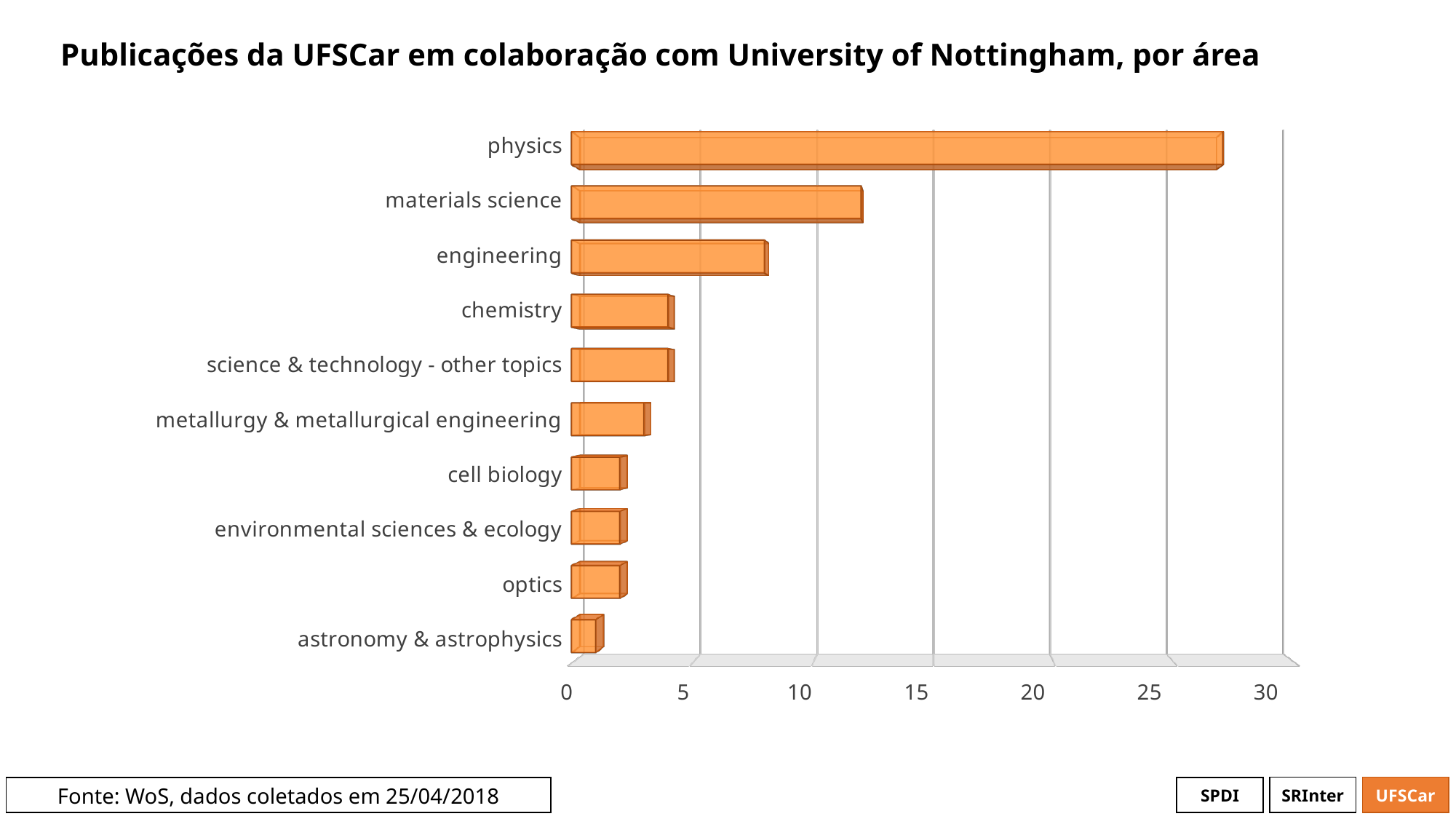
Is the value for materials science greater or less than 10? greater How many areas (categories) are shown in the chart? 10 Is the value for metallurgy & metallurgical engineering greater or less than 5? less Is the value for chemistry greater or less than 5? less Which area has the highest number of publications? physics What is the title of the chart? Publicações da UFSCar em colaboração com University of Nottingham, por área Which has more publications, cell biology or metallurgy & metallurgical engineering? metallurgy & metallurgical engineering Which area has the lowest number of publications? astronomy & astrophysics What kind of chart is shown on the slide? bar chart Which has more publications, materials science or engineering? materials science